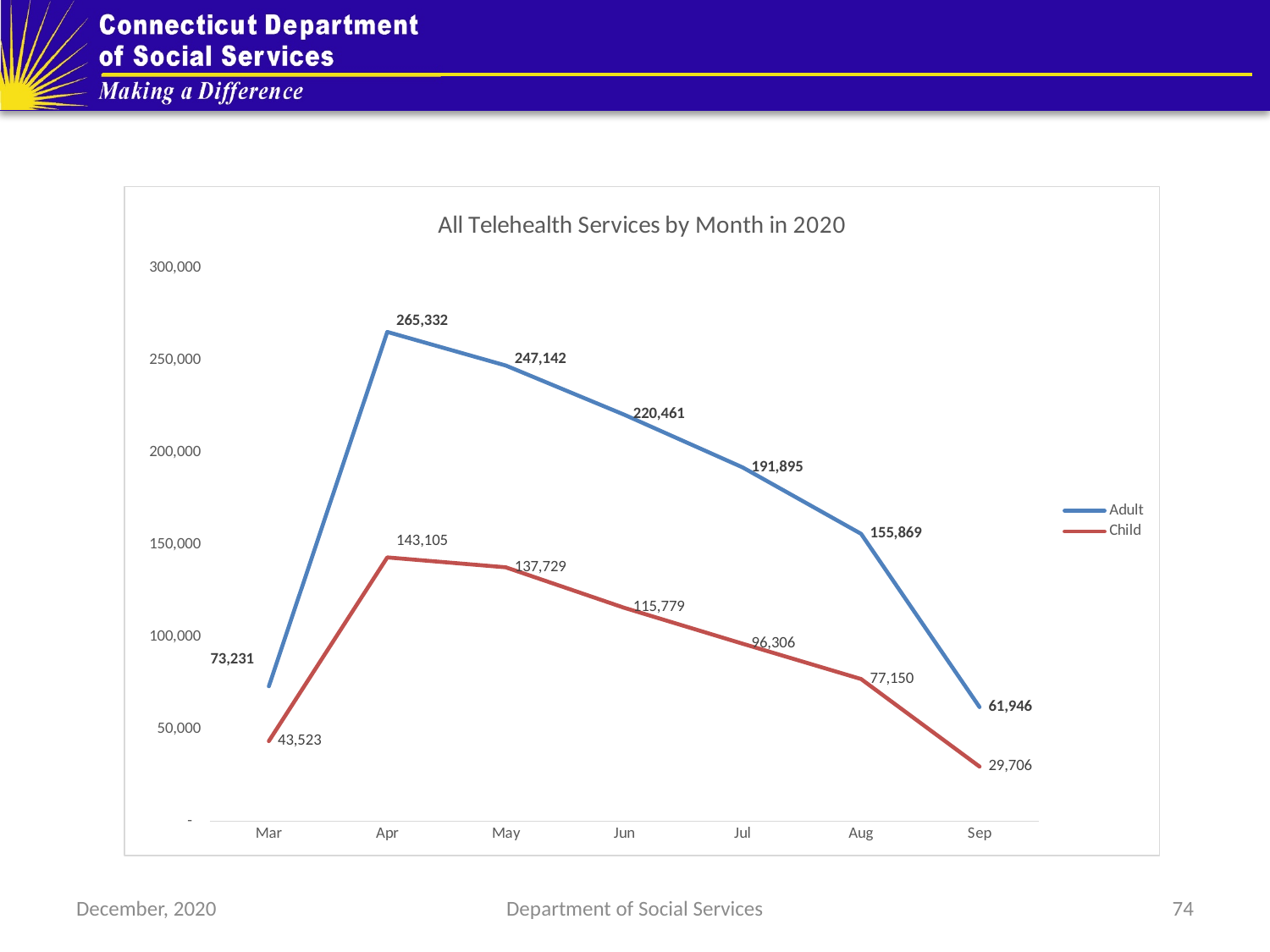
Which month has the lowest Adult value? Sep Do the Adult values rise or fall from Apr to Sep? fall Which month has the highest Child value? Apr What is the Adult value for Apr? 265,332 What is the Adult value for Sep? 61,946 How many months are shown on the x axis? 7 What kind of chart is shown? line chart What is the Child value for Jul? 96,306 Which is larger, the Adult value for Mar or the Child value for Aug? Child value for Aug Is the Adult value for Aug greater or less than 150,000? greater How many series does the legend list? 2 What is the difference between the Adult and Child values for Jun? 104,682